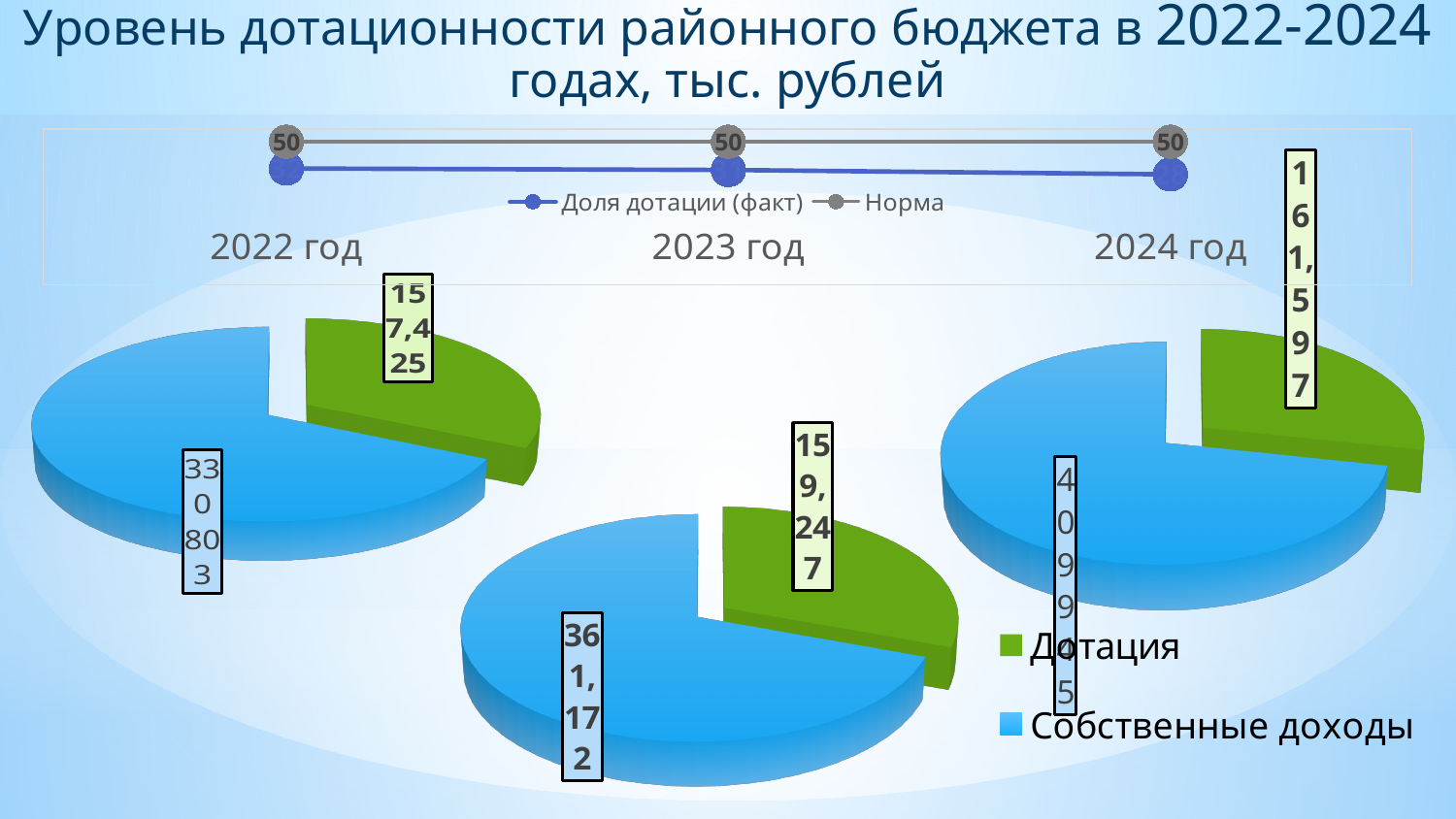
What is the difference between the Дотация value for 2024 год and for 2022 год? 4,172 In the line chart at the top, what is the value of Норма for 2023 год? 50 What kind of chart is used to show the 2022 год budget breakdown? pie chart In the 2022 год pie chart, what is the value for Дотация? 157,425 In the 2023 год pie chart, which is larger, Дотация or Собственные доходы? Собственные доходы How many pie charts are shown on the slide? 3 In the 2024 год pie chart, what is the value for Дотация? 161,597 In the 2023 год pie chart, what is the value for Собственные доходы? 361,172 In the 2023 год pie chart, what is the value for Дотация? 159,247 Do the Дотация values rise or fall from 2022 год to 2024 год? rise Across the three pie charts, which year has the highest Дотация value? 2024 год How many series does the legend of the pie charts list? 2